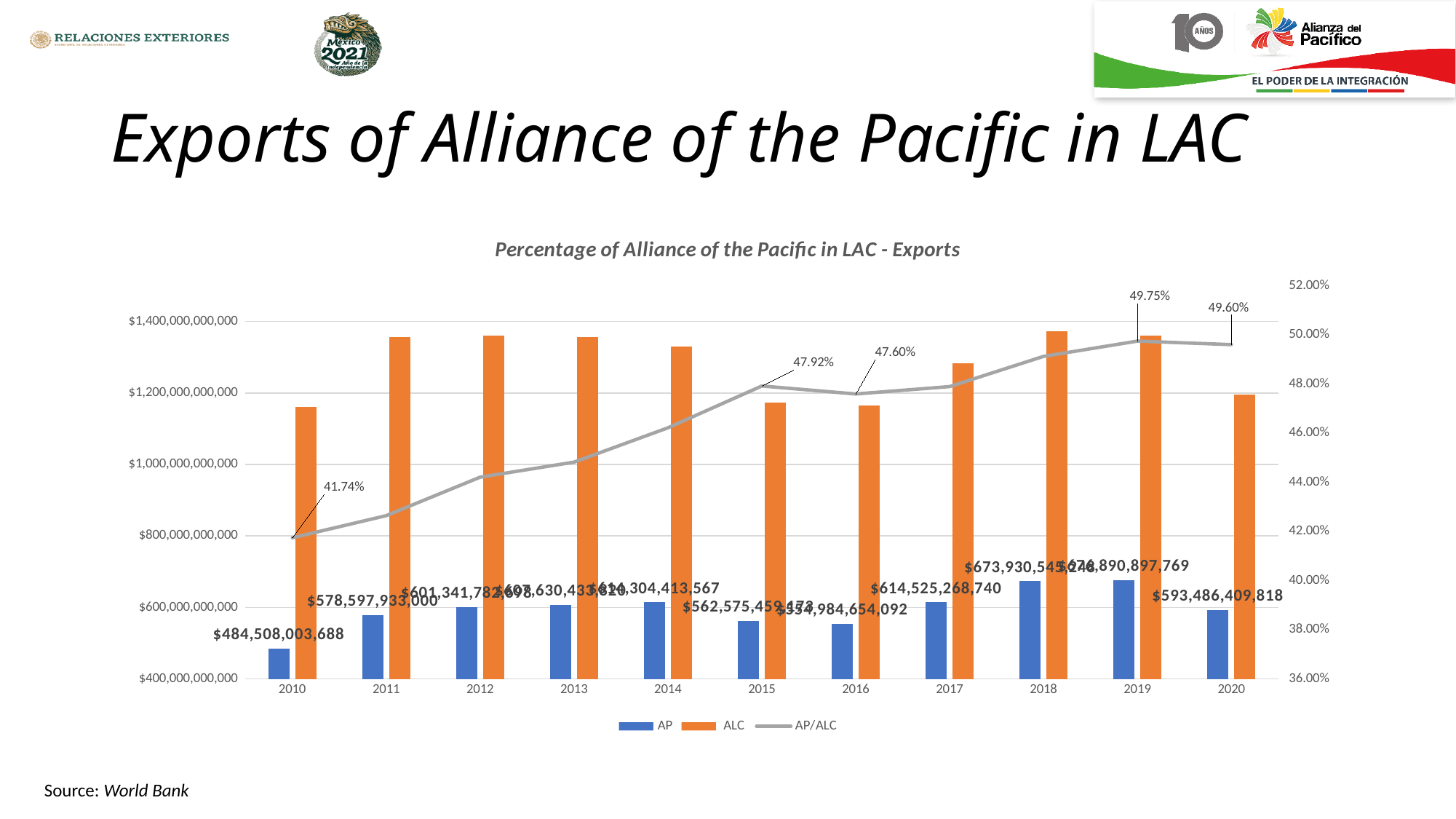
Which year has the larger AP value, 2019 or 2020? 2019 What kind of chart is shown on the slide? bar chart with a line In which year is the AP/ALC line at its highest? 2019 What is the AP/ALC percentage for 2019? 49.75% How many series does the legend list? 3 What is the AP value for 2010? $484,508,003,688 What is the AP value for 2020? $593,486,409,818 What is the AP/ALC percentage for 2010? 41.74% What is the difference between the AP/ALC percentages for 2019 and 2020? 0.15% How many years are shown on the x axis? 11 Is the ALC value for 2010 greater or less than $1,200,000,000,000? less